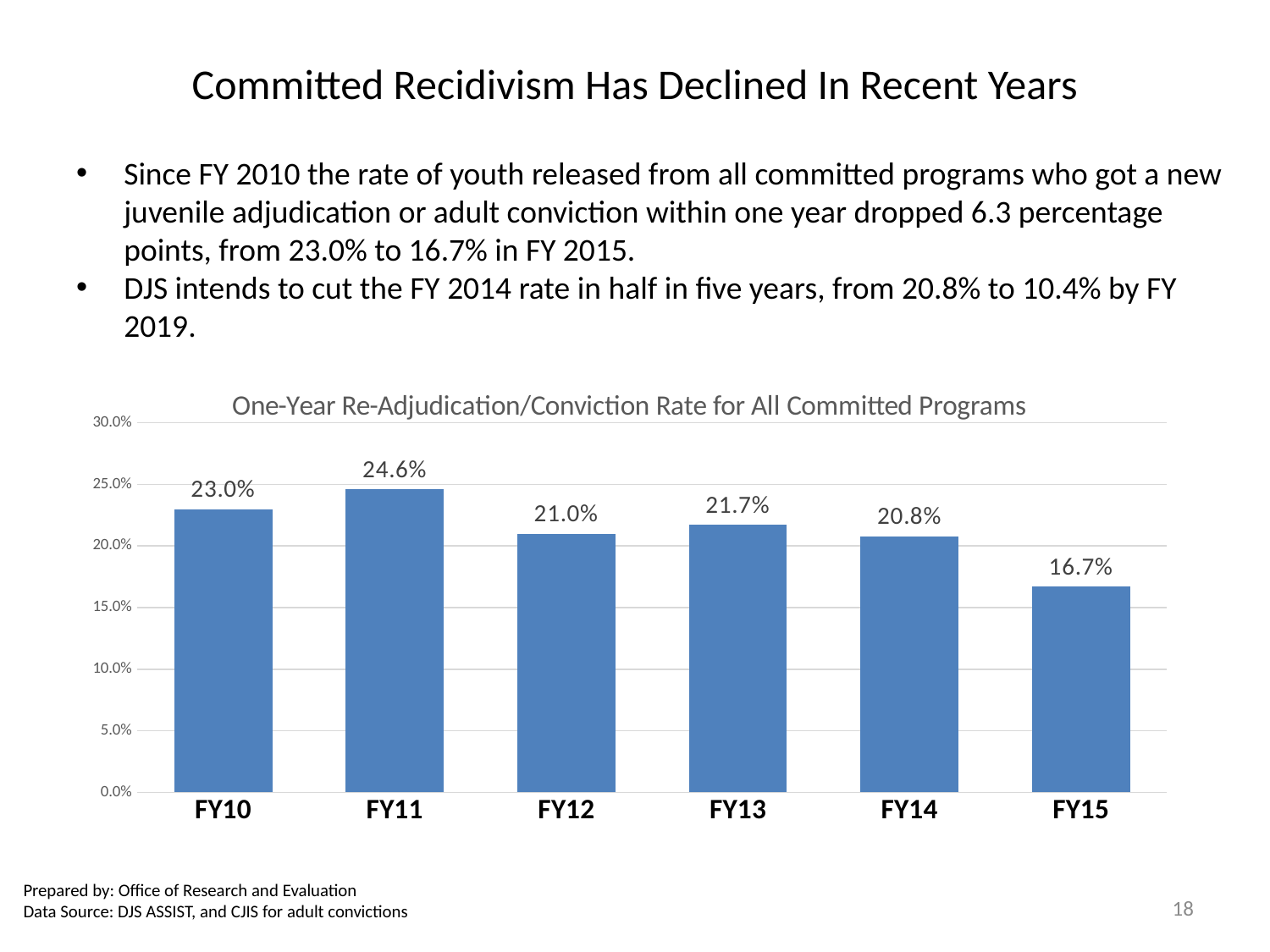
Which fiscal year has the highest one-year re-adjudication/conviction rate? FY11 What is the value shown for FY13? 21.7% What kind of chart is shown on the slide? Bar chart What is the difference between the FY10 and FY14 rates? 2.2 percentage points Is the value for FY14 greater or less than 25.0%? less Which fiscal year has the lowest one-year re-adjudication/conviction rate? FY15 What is the one-year re-adjudication/conviction rate for FY10? 23.0% Which is larger, the rate for FY12 or the rate for FY13? FY13 What is the one-year re-adjudication/conviction rate for FY15? 16.7% How many fiscal years are shown on the chart? 6 By how many percentage points did the rate fall from FY11 to FY15? 7.9 percentage points What is the title of the chart? One-Year Re-Adjudication/Conviction Rate for All Committed Programs